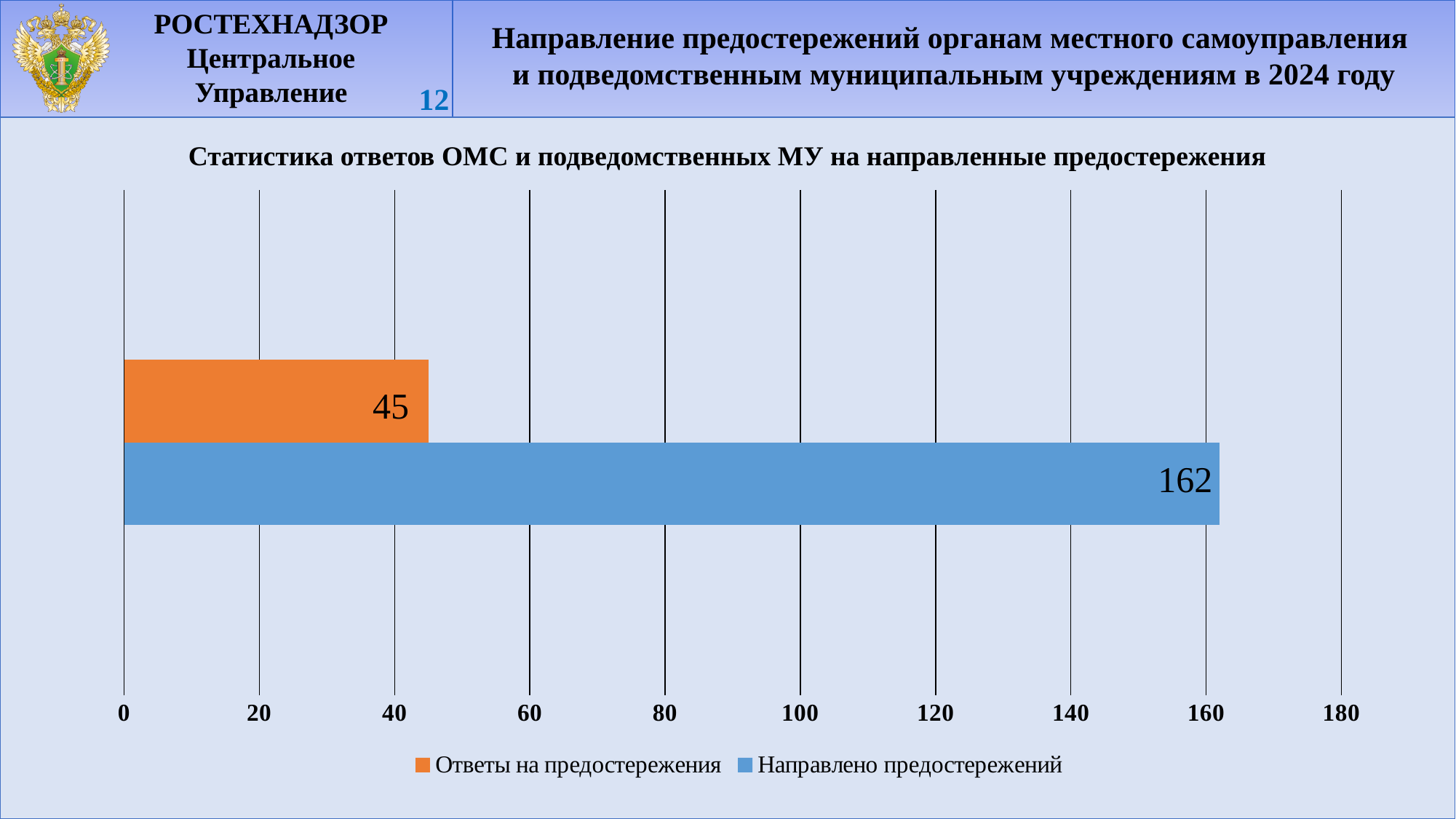
Is the value for "Ответы на предостережения" greater or less than 60? less Which series has the highest value? Направлено предостережений What is the title of the chart? Статистика ответов ОМС и подведомственных МУ на направленные предостережения Which series has the lowest value? Ответы на предостережения Is the value for "Направлено предостережений" greater or less than 140? greater What is the value for "Направлено предостережений"? 162 What colour is the bar for "Ответы на предостережения"? Orange Which series has the higher value, "Ответы на предостережения" or "Направлено предостережений"? Направлено предостережений What is the value for "Ответы на предостережения"? 45 How many series does the legend list? 2 What kind of chart is shown on the slide? Bar chart What is the difference between the value for "Направлено предостережений" and the value for "Ответы на предостережения"? 117